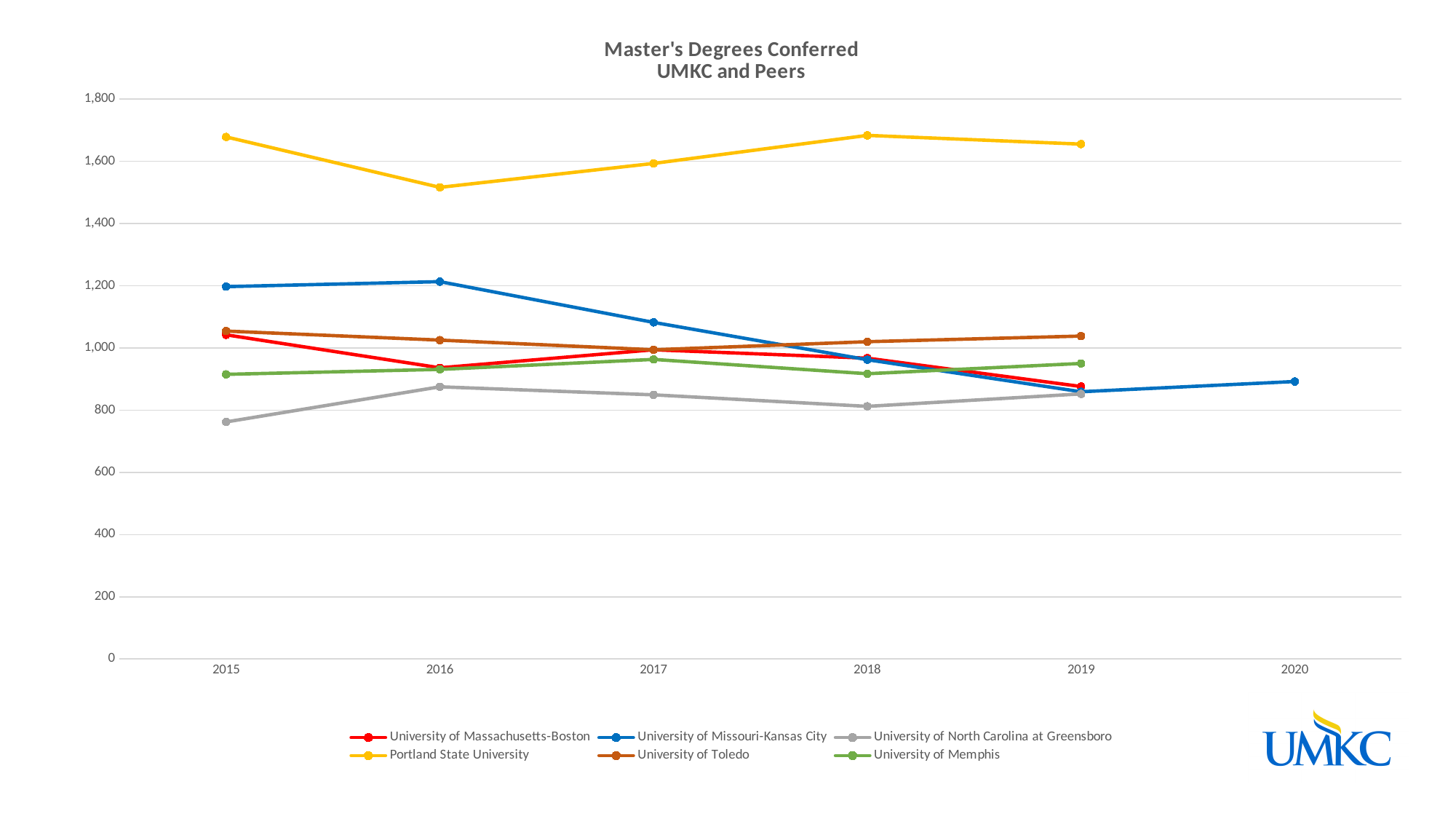
Is the value for University of North Carolina at Greensboro in 2015 greater or less than 800? less Is the value for Portland State University in 2016 greater or less than 1,600? less What is the title of the chart? Master's Degrees Conferred UMKC and Peers How many universities does the legend list? 6 Which university conferred the fewest master's degrees in 2015? University of North Carolina at Greensboro Is the value for University of Missouri-Kansas City in 2015 greater or less than 1,000? greater How many years are shown on the x axis? 6 Does the University of Missouri-Kansas City line rise or fall from 2016 to 2019? fall Which university is the only one with a data point plotted for 2020? University of Missouri-Kansas City Which university conferred the most master's degrees in 2015? Portland State University What kind of chart is shown on the slide? line chart In 2019, which conferred more master's degrees: University of Toledo or University of Missouri-Kansas City? University of Toledo